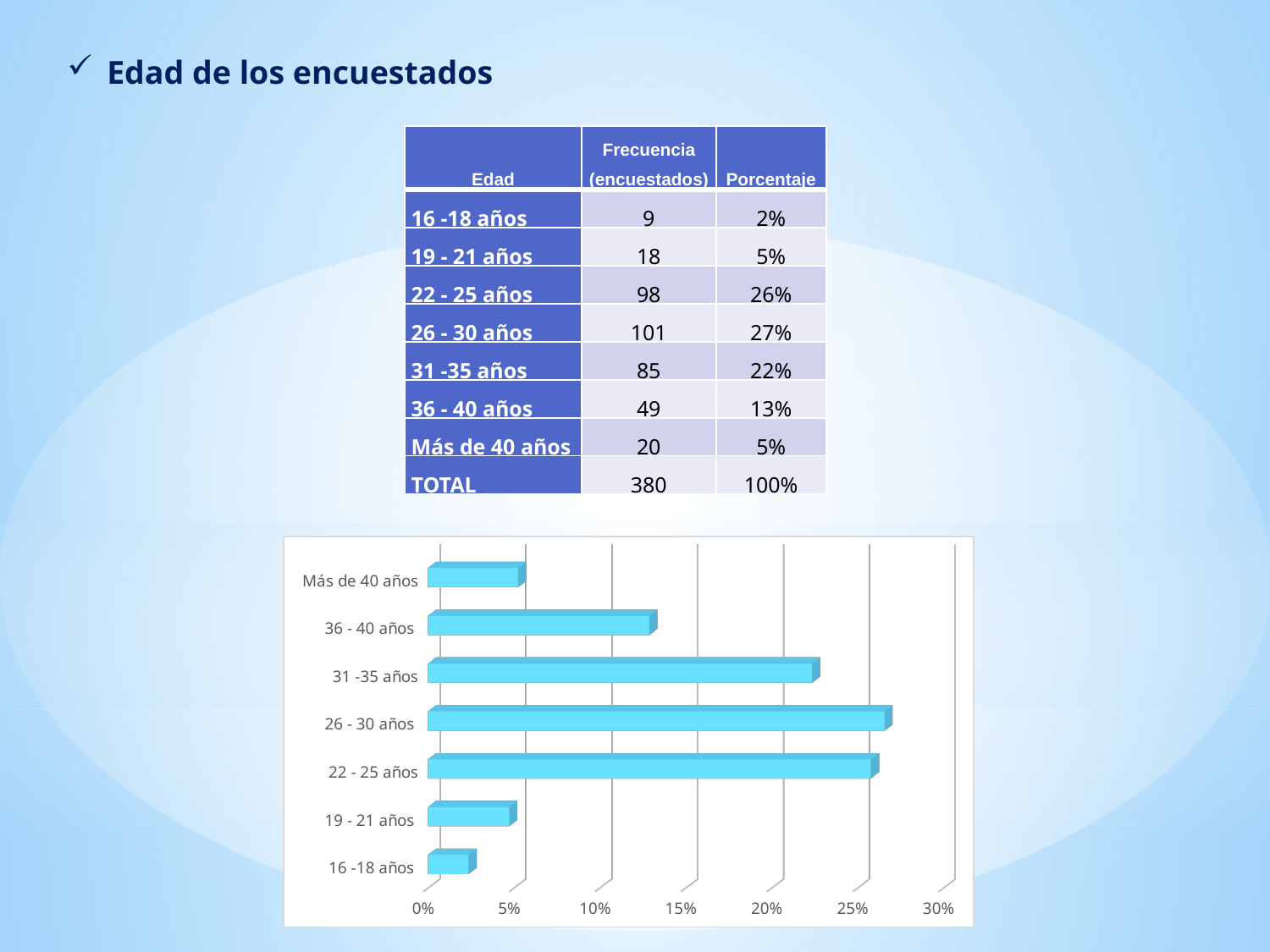
Which age category has the shortest bar in the chart? 16 -18 años What kind of chart is shown on the slide? bar chart What is the difference in percentage points between 31 -35 años and 36 - 40 años? 9% Is the value for 31 -35 años greater or less than 20%? greater What percentage is plotted for 31 -35 años? 22% Which age category has the longest bar in the chart? 26 - 30 años Which bar is longer, 31 -35 años or 36 - 40 años? 31 -35 años Is the value for 36 - 40 años greater or less than 15%? less What is the highest value shown on the chart's horizontal axis? 30% How many age categories are plotted in the bar chart? 7 What percentage is plotted for 36 - 40 años? 13% What percentage is plotted for 22 - 25 años? 26%